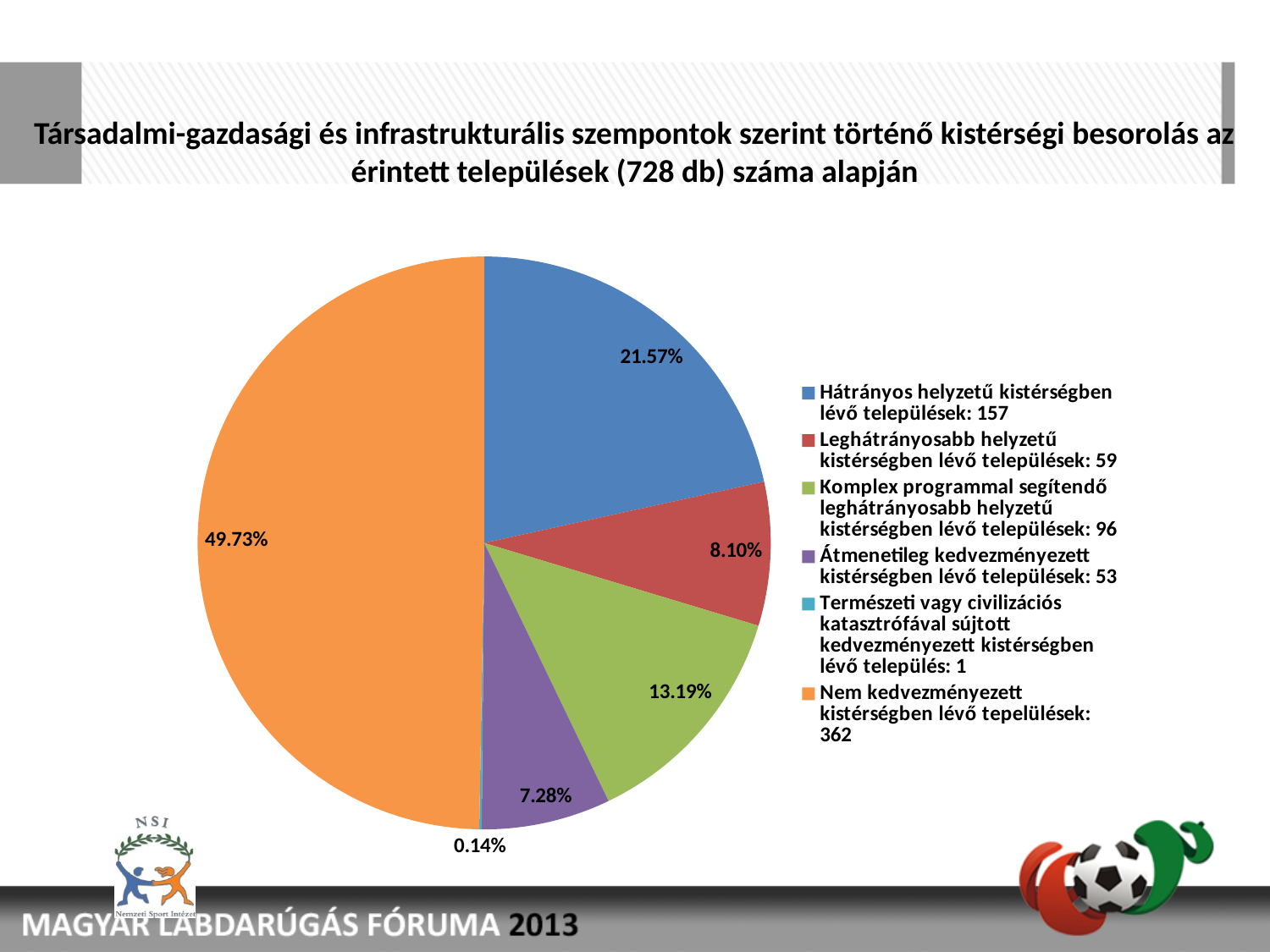
How many slices does the pie chart have? 6 What percentage is shown for 'Nem kedvezményezett kistérségben lévő tepelülések'? 49.73% What share of the pie is labelled for 'Hátrányos helyzetű kistérségben lévő települések'? 21.57% Which category has the largest slice of the pie? Nem kedvezményezett kistérségben lévő tepelülések What colour is the slice for 'Átmenetileg kedvezményezett kistérségben lévő települések'? purple According to the legend, how many settlements are in the 'Nem kedvezményezett kistérségben lévő tepelülések' category? 362 What percentage is shown for 'Komplex programmal segítendő leghátrányosabb helyzetű kistérségben lévő települések'? 13.19% Which category has the smallest slice of the pie? Természeti vagy civilizációs katasztrófával sújtott kedvezményezett kistérségben lévő település What kind of chart is shown on the slide? pie chart What is the difference in percentage points between the 'Hátrányos helyzetű' slice (21.57%) and the 'Leghátrányosabb helyzetű' slice (8.10%)? 13.47% Which slice is larger: 'Leghátrányosabb helyzetű kistérségben lévő települések' or 'Komplex programmal segítendő leghátrányosabb helyzetű kistérségben lévő települések'? Komplex programmal segítendő leghátrányosabb helyzetű kistérségben lévő települések